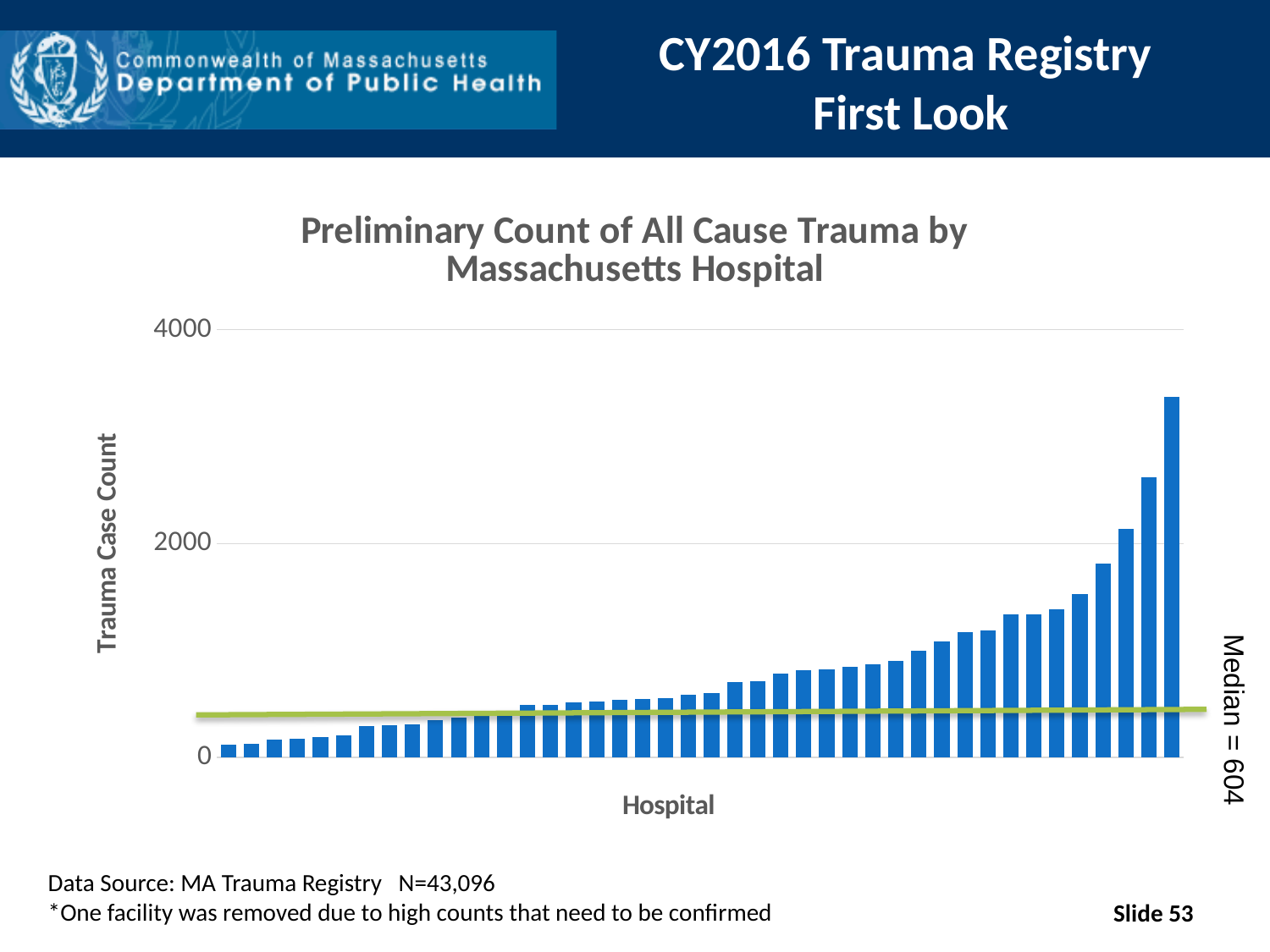
What is the label on the vertical axis of the chart? Trauma Case Count Do the bar values rise or fall from left to right along the x axis? Rise What kind of chart is shown on the slide? Bar chart Is the value of the tallest bar greater or less than 2000? greater Where on the chart is the lowest bar located, at the left end or the right end? The left end Which bar is the highest: the leftmost bar or the rightmost bar? The rightmost bar Is the value of the tallest bar greater or less than 4000? less Is the value of the shortest bar (leftmost) greater or less than 2000? less What median value is marked by the horizontal line on the chart? 604 What is the title of the chart? Preliminary Count of All Cause Trauma by Massachusetts Hospital